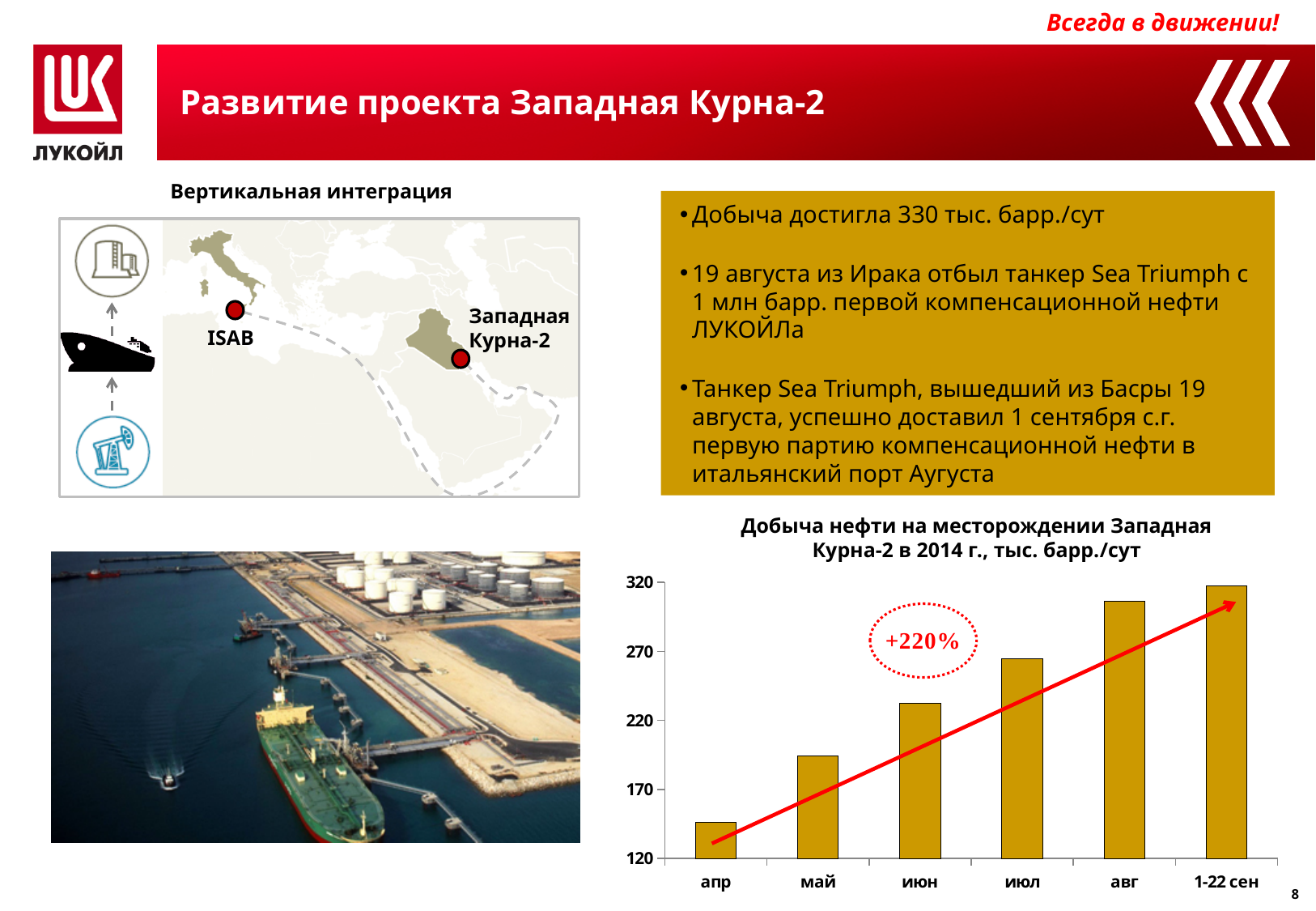
Which category has the lowest value in the chart? апр Is the value for авг greater or less than 270? greater What kind of chart is shown on the slide? bar chart Which category has the highest value in the chart? 1-22 сен How many categories are shown on the x axis of the chart? 6 Is the value for июн greater or less than 220? greater Is the value for май greater or less than 170? greater Which is larger, the value for авг or the value for май? авг Do the values rise or fall from апр to 1-22 сен? rise What percentage growth is shown in the dotted circle annotation on the chart? +220%